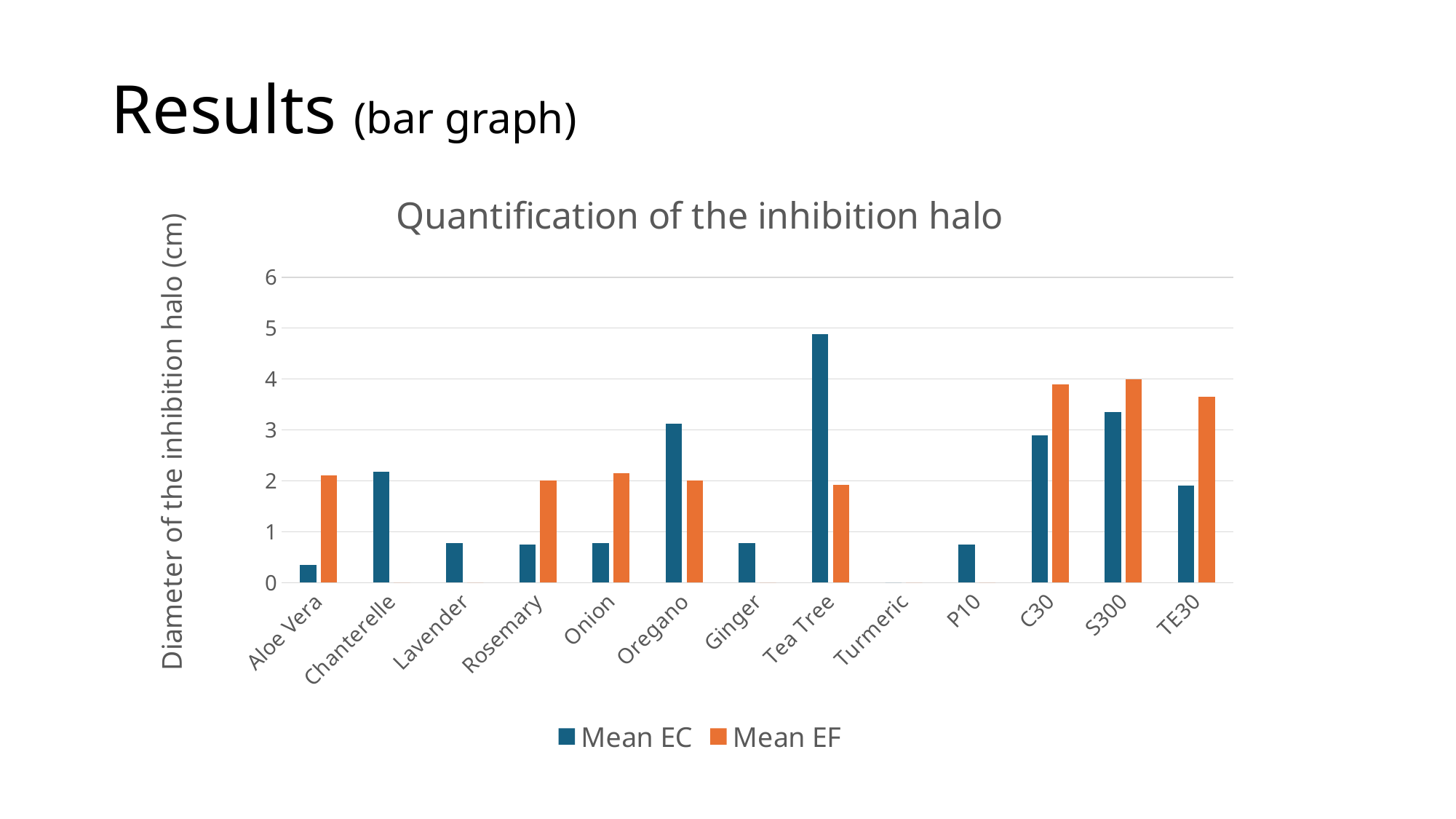
Is the Mean EC value for Aloe Vera greater or less than 1? less What is the title of the chart? Quantification of the inhibition halo Is the Mean EC value for Tea Tree greater or less than 4? greater For TE30, which is larger: Mean EC or Mean EF? Mean EF For Tea Tree, which is larger: Mean EC or Mean EF? Mean EC How many series does the legend list? 2 Is the Mean EC value for Oregano greater or less than 3? greater What kind of chart is shown on the slide? bar chart What is the label of the y axis? Diameter of the inhibition halo (cm) How many categories are shown on the x axis? 13 Which category has the highest Mean EC value? Tea Tree